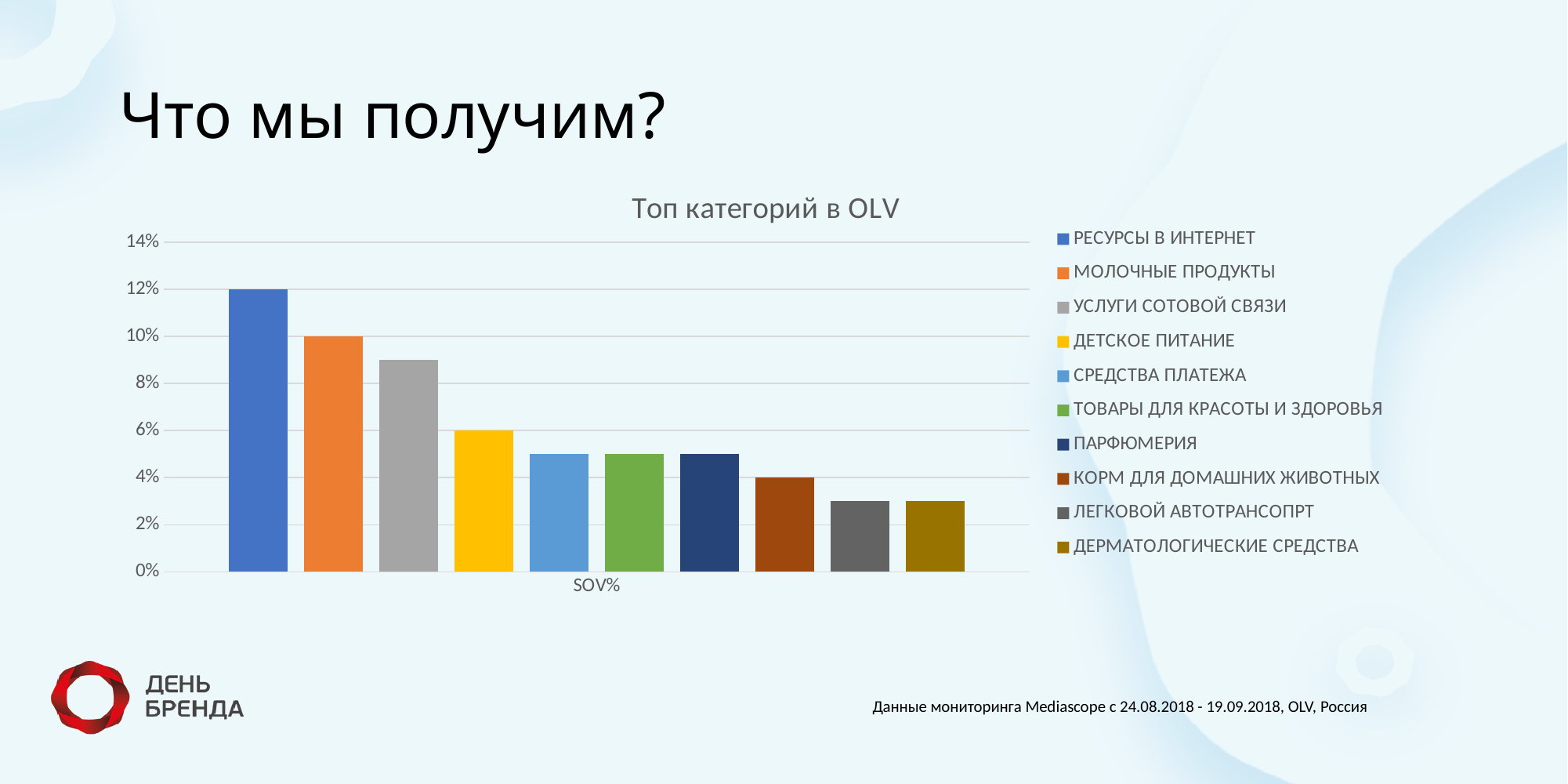
What is the value for РЕСУРСЫ В ИНТЕРНЕТ? 12% What is the value for МОЛОЧНЫЕ ПРОДУКТЫ? 10% How many series does the chart legend list? 10 What is the value for ДЕТСКОЕ ПИТАНИЕ? 6% Is the value for УСЛУГИ СОТОВОЙ СВЯЗИ greater or less than 8%? greater What is the title of the chart? Топ категорий в OLV What type of chart is shown on the slide? Bar chart Is the value for ПАРФЮМЕРИЯ greater or less than 6%? less What is the value for КОРМ ДЛЯ ДОМАШНИХ ЖИВОТНЫХ? 4% Which series has the highest value in the chart? РЕСУРСЫ В ИНТЕРНЕТ Which is larger, the value for МОЛОЧНЫЕ ПРОДУКТЫ or the value for ДЕТСКОЕ ПИТАНИЕ? МОЛОЧНЫЕ ПРОДУКТЫ What is the difference between the values for РЕСУРСЫ В ИНТЕРНЕТ and МОЛОЧНЫЕ ПРОДУКТЫ? 2%